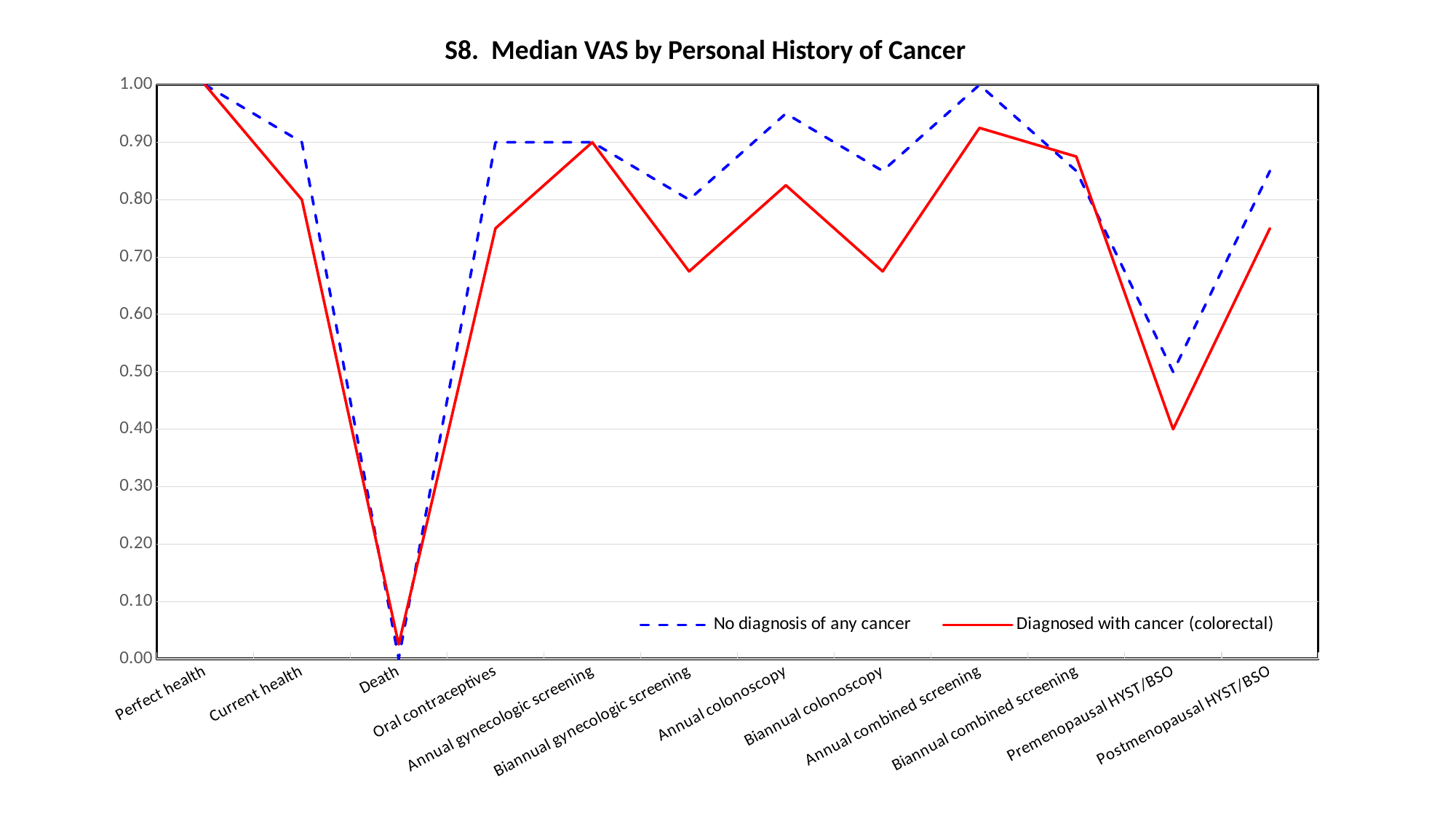
Is the value for Postmenopausal HYST/BSO in the 'No diagnosis of any cancer' series greater or less than 0.80? greater Which category has the highest value for the 'Diagnosed with cancer (colorectal)' series? Perfect health Which category has the lowest value for the 'Diagnosed with cancer (colorectal)' series? Death Is the value for Biannual colonoscopy in the 'Diagnosed with cancer (colorectal)' series greater or less than 0.80? less What is the value for Annual combined screening in the 'No diagnosis of any cancer' series? 1.00 What is the title of the chart? S8. Median VAS by Personal History of Cancer For Annual colonoscopy, which series has the higher value? No diagnosis of any cancer How many series does the legend list? 2 How many categories are shown along the x axis? 12 What is the value for Premenopausal HYST/BSO in the 'No diagnosis of any cancer' series? 0.50 What is the value for Premenopausal HYST/BSO in the 'Diagnosed with cancer (colorectal)' series? 0.40 What kind of chart is shown on the slide? Line chart